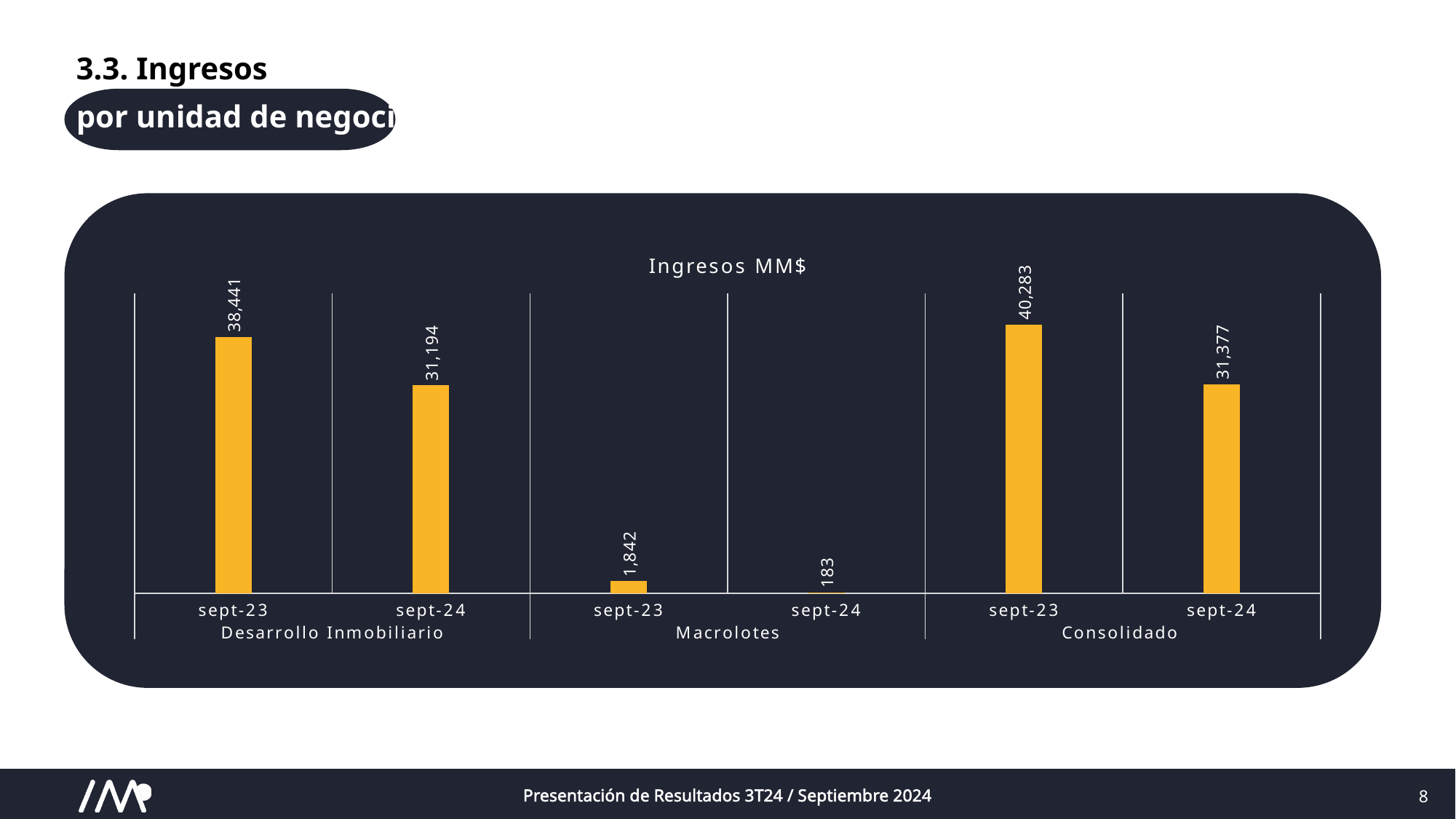
What is the difference between sept-23 and sept-24 under Consolidado? 8,906 What type of chart is shown on the slide? bar chart What is the value for sept-23 under Desarrollo Inmobiliario? 38,441 What is the chart's title? Ingresos MM$ How many bars are plotted in the chart? 6 Which bar has the lowest value in the chart? sept-24 Macrolotes Which bar has the highest value in the chart? sept-23 Consolidado What is the difference between sept-23 and sept-24 under Desarrollo Inmobiliario? 7,247 What is the value for sept-24 under Consolidado? 31,377 Which is larger: sept-24 Desarrollo Inmobiliario or sept-24 Consolidado? sept-24 Consolidado What is the value for sept-24 under Macrolotes? 183 What is the value for sept-23 under Consolidado? 40,283